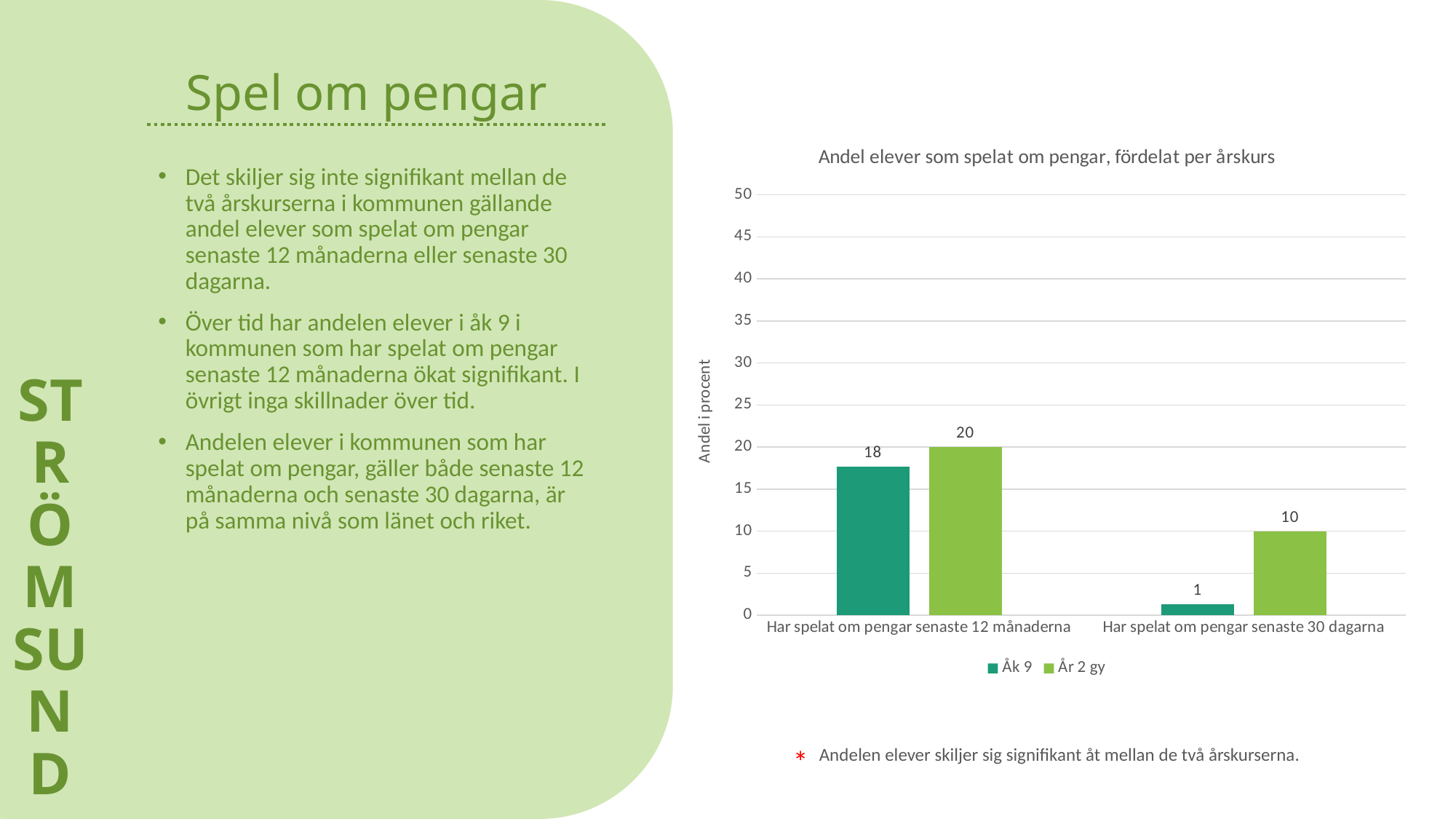
How many series does the legend list? 2 How many categories are shown on the x axis? 2 Which bar has the lowest value in the chart? Åk 9, Har spelat om pengar senaste 30 dagarna What is the value for År 2 gy in the category 'Har spelat om pengar senaste 30 dagarna'? 10 Which series has the highest value in the category 'Har spelat om pengar senaste 12 månaderna'? År 2 gy Which is larger: Åk 9 for 'senaste 12 månaderna' or År 2 gy for 'senaste 30 dagarna'? Åk 9 for senaste 12 månaderna What is the value for Åk 9 in the category 'Har spelat om pengar senaste 30 dagarna'? 1 Is the value for År 2 gy in 'Har spelat om pengar senaste 12 månaderna' greater or less than 15? greater What is the difference between År 2 gy and Åk 9 in the category 'Har spelat om pengar senaste 30 dagarna'? 9 What is the value for År 2 gy in the category 'Har spelat om pengar senaste 12 månaderna'? 20 What is the value for Åk 9 in the category 'Har spelat om pengar senaste 12 månaderna'? 18 What kind of chart is shown on the slide? Bar chart